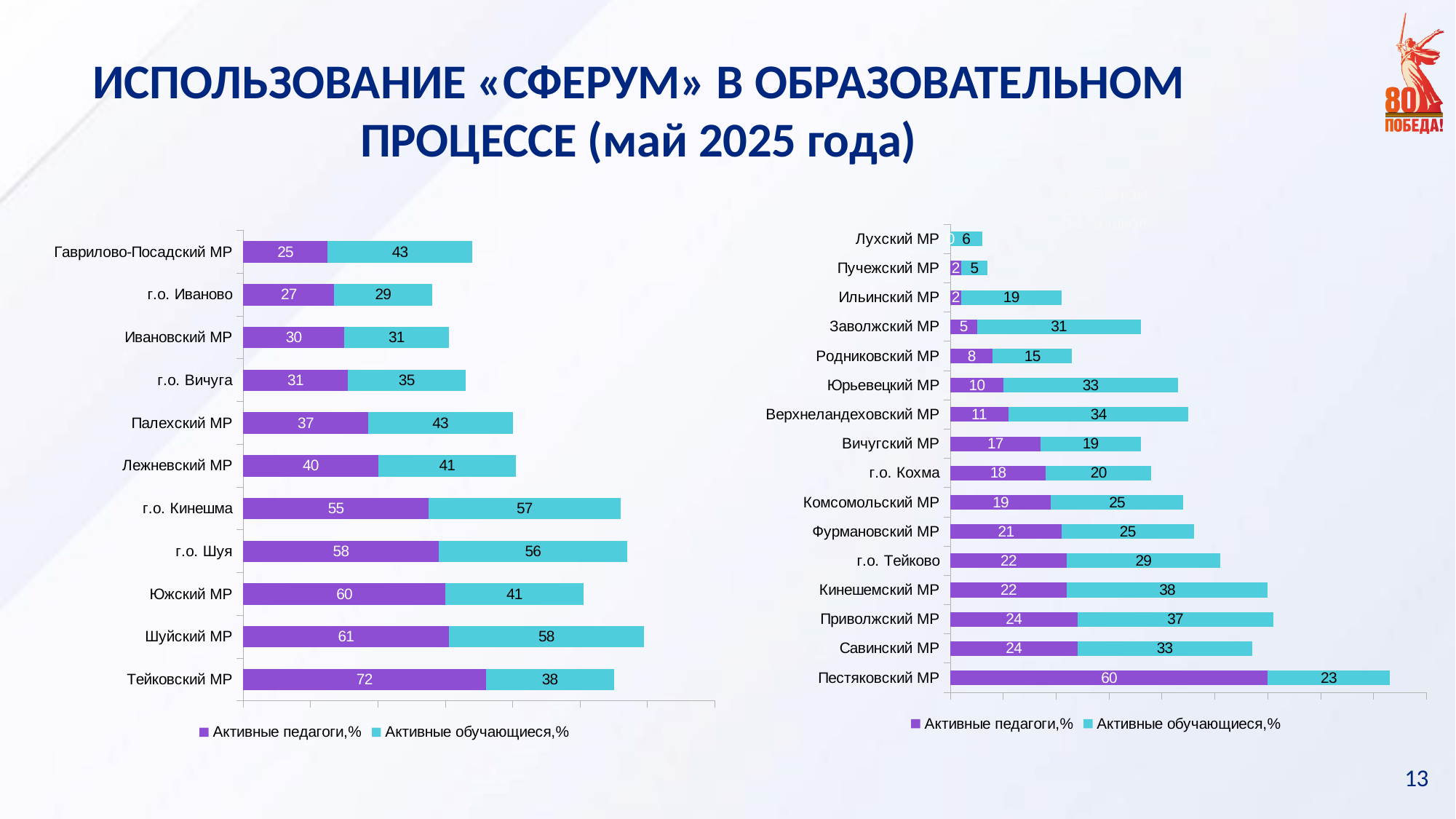
How many categories are shown in the right chart? 16 In the left chart, what is the difference between Активные обучающиеся,% and Активные педагоги,% for Гаврилово-Посадский МР? 18 In the right chart, which category has the lowest value of Активные обучающиеся,%? Пучежский МР In the right chart, which is larger for Пестяковский МР: Активные педагоги,% or Активные обучающиеся,%? Активные педагоги,% What type of chart is the right chart? Stacked bar chart How many series does the legend of the left chart list? 2 In the right chart, what is the value of Активные обучающиеся,% for Заволжский МР? 31 How many categories are shown in the left chart? 11 In the left chart, which category has the highest value of Активные педагоги,%? Тейковский МР In the left chart, what is the value of Активные педагоги,% for Тейковский МР? 72 In the left chart, what is the total of the stacked bar for Шуйский МР? 119 In the right chart, what is the total of the stacked bar for Кинешемский МР? 60